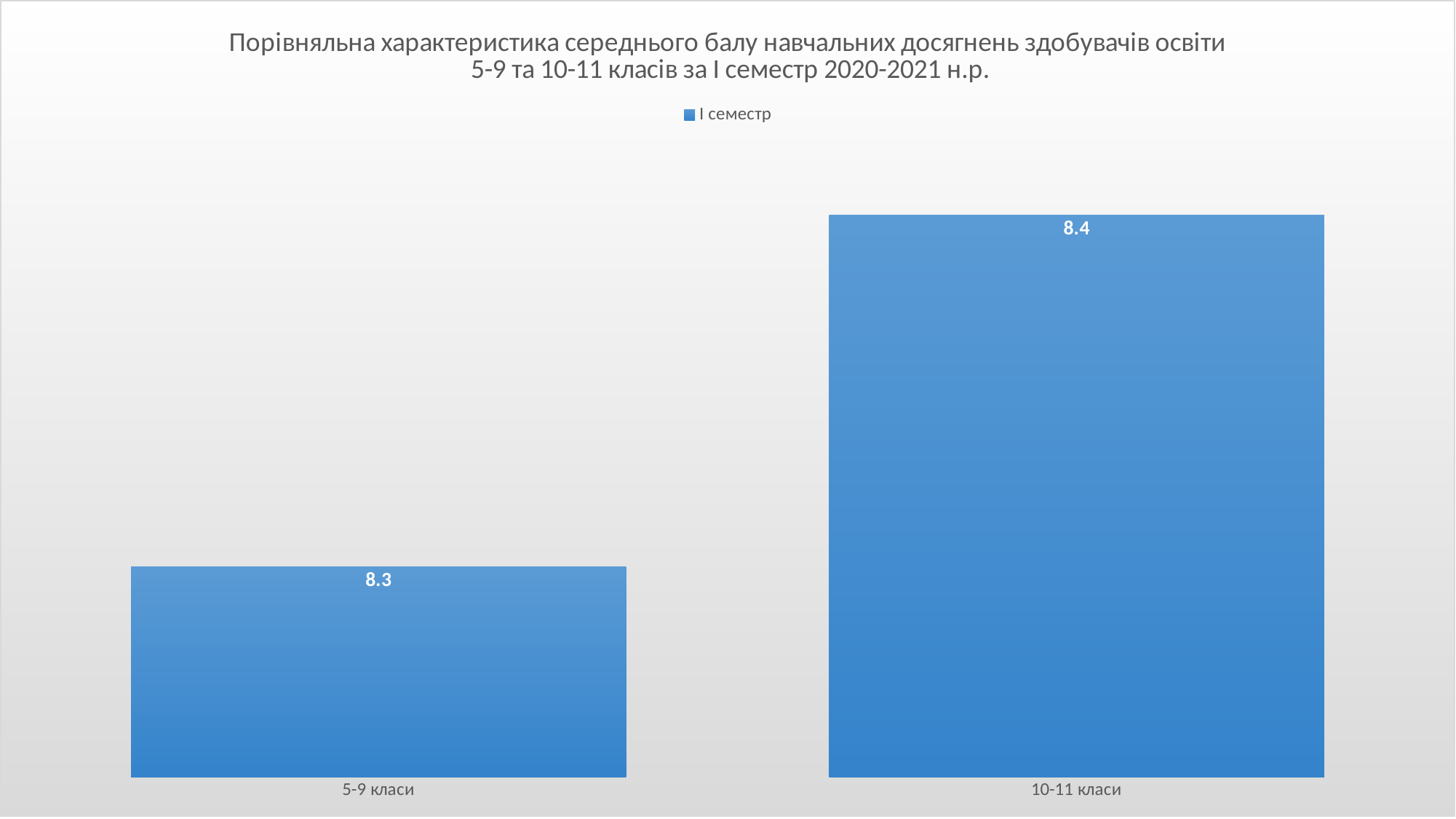
What is the value for 5-9 класи? 8.3 What kind of chart is shown on the slide? bar chart Which category has the lowest value? 5-9 класи How many series does the legend list? 1 Which is larger, the value for 5-9 класи or the value for 10-11 класи? 10-11 класи What colour are the bars on the chart? blue Which category has the highest value? 10-11 класи What is the value for 10-11 класи? 8.4 What is the difference between the values for 10-11 класи and 5-9 класи? 0.1 How many categories are shown on the chart? 2 What series name is shown in the legend? І семестр Do the values rise or fall from 5-9 класи to 10-11 класи? rise